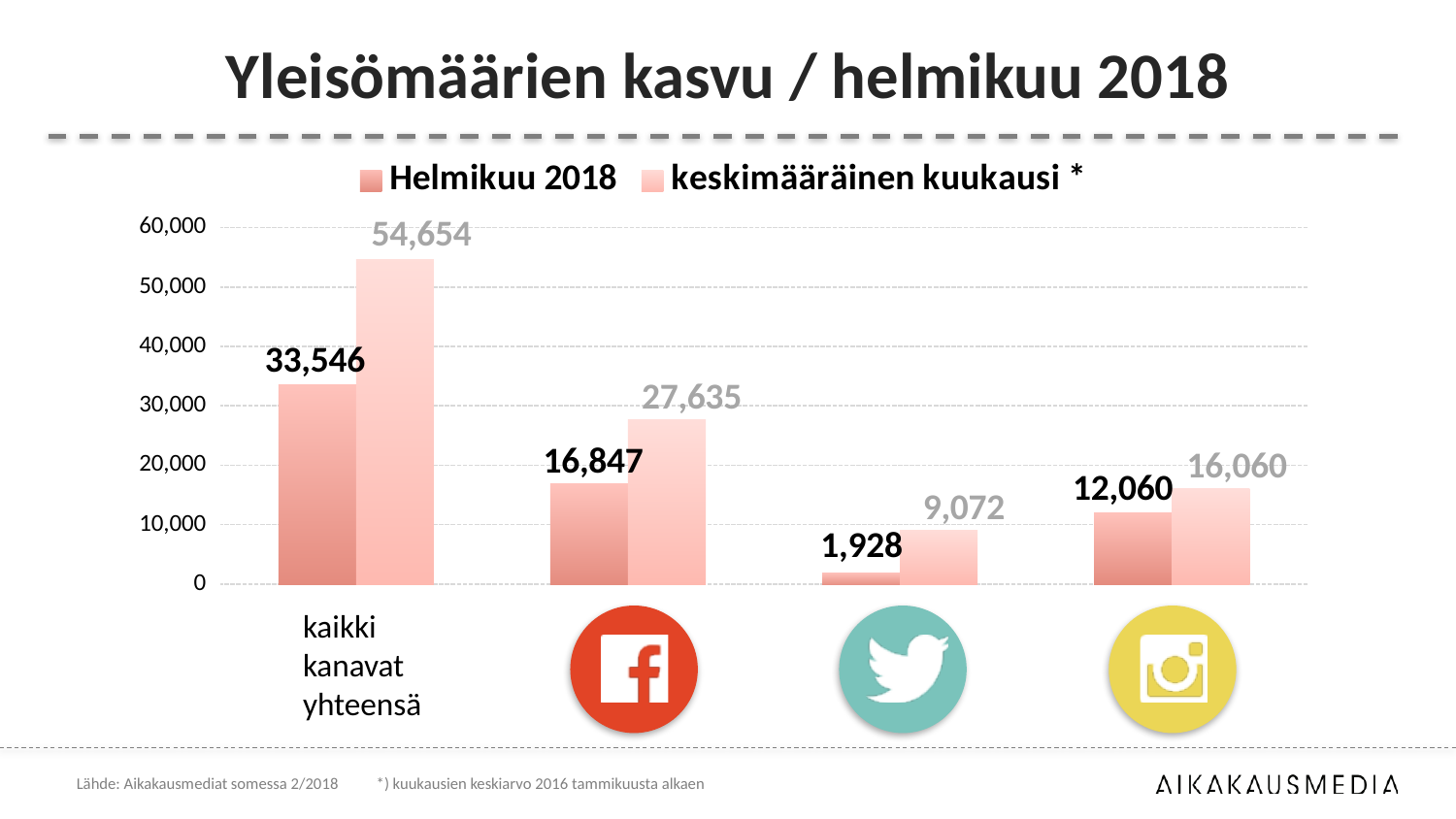
What is the difference between the keskimääräinen kuukausi and Helmikuu 2018 values for the Instagram category? 4,000 How many categories are shown on the x axis? 4 What is the difference between the keskimääräinen kuukausi and Helmikuu 2018 values for kaikki kanavat yhteensä? 21,108 Which category has the lowest Helmikuu 2018 value? Twitter Which category has the highest keskimääräinen kuukausi value? kaikki kanavat yhteensä What is the Helmikuu 2018 value for kaikki kanavat yhteensä? 33,546 What is the Helmikuu 2018 value for the Twitter category? 1,928 What kind of chart is shown on the slide? Bar chart What is the keskimääräinen kuukausi value for the Facebook category? 27,635 How many series does the legend list? 2 What is the keskimääräinen kuukausi value for the Instagram category? 16,060 Which is larger: the Helmikuu 2018 value for Facebook or the Helmikuu 2018 value for Instagram? Facebook